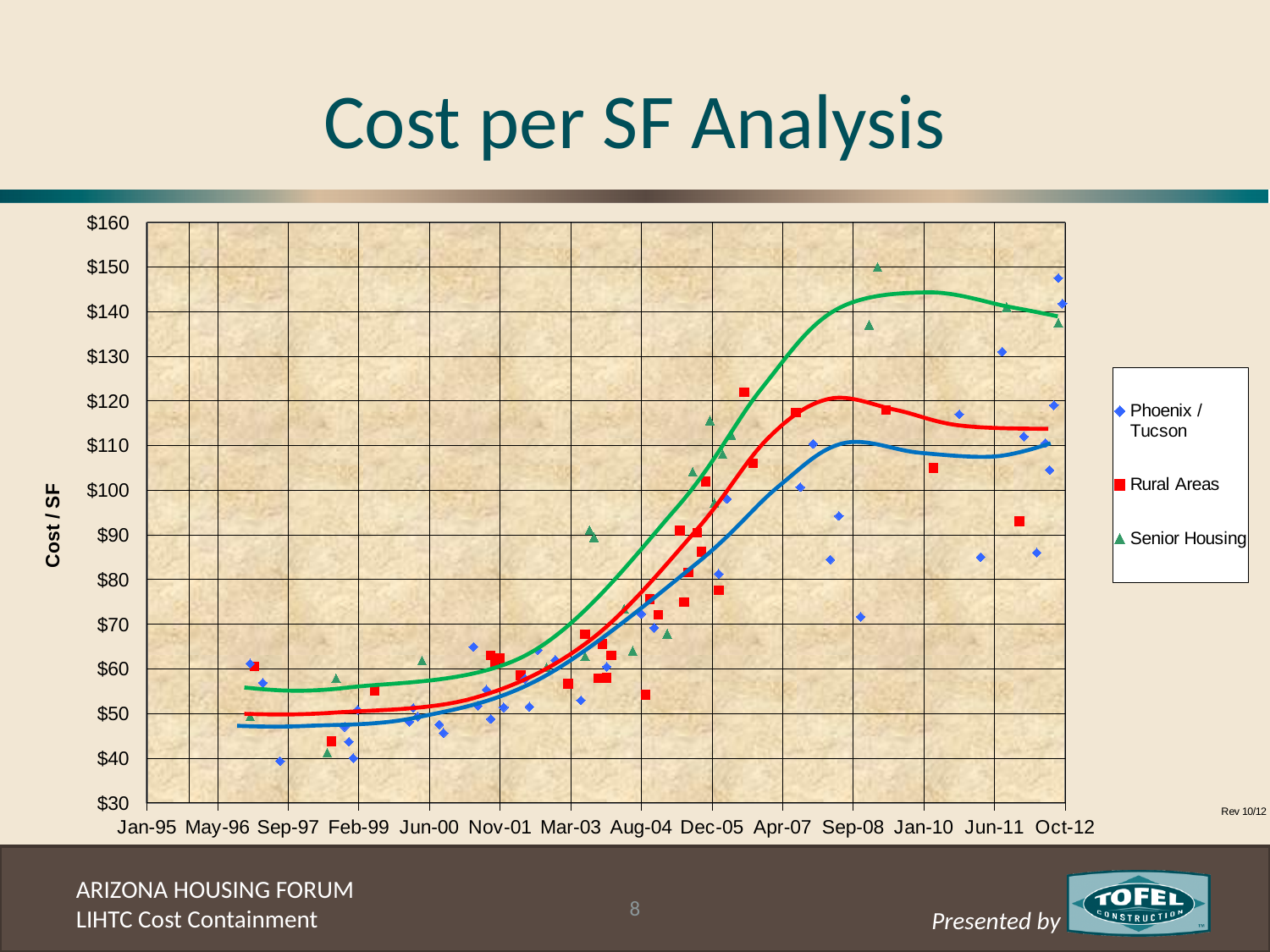
Which marker shape and colour represents Senior Housing in the legend? green triangles Overall, do the cost per SF values rise or fall from Jan-95 to Oct-12? rise How many date labels are shown along the x axis? 14 Around Sep-08, which series' trend line is the highest? Senior Housing Is the highest Senior Housing point, near Sep-08, greater or less than $140? greater What is the title of the chart? Cost per SF Analysis What kind of chart is shown on the slide? scatter chart How many series does the legend list? 3 Is the Rural Areas point near Jan-10 greater or less than $100? greater Around Sep-08, which series' trend line is the lowest? Phoenix / Tucson Is the lowest Phoenix / Tucson point, near Sep-97, greater or less than $50? less Around Apr-07, is the Senior Housing trend line higher or lower than the Rural Areas trend line? higher